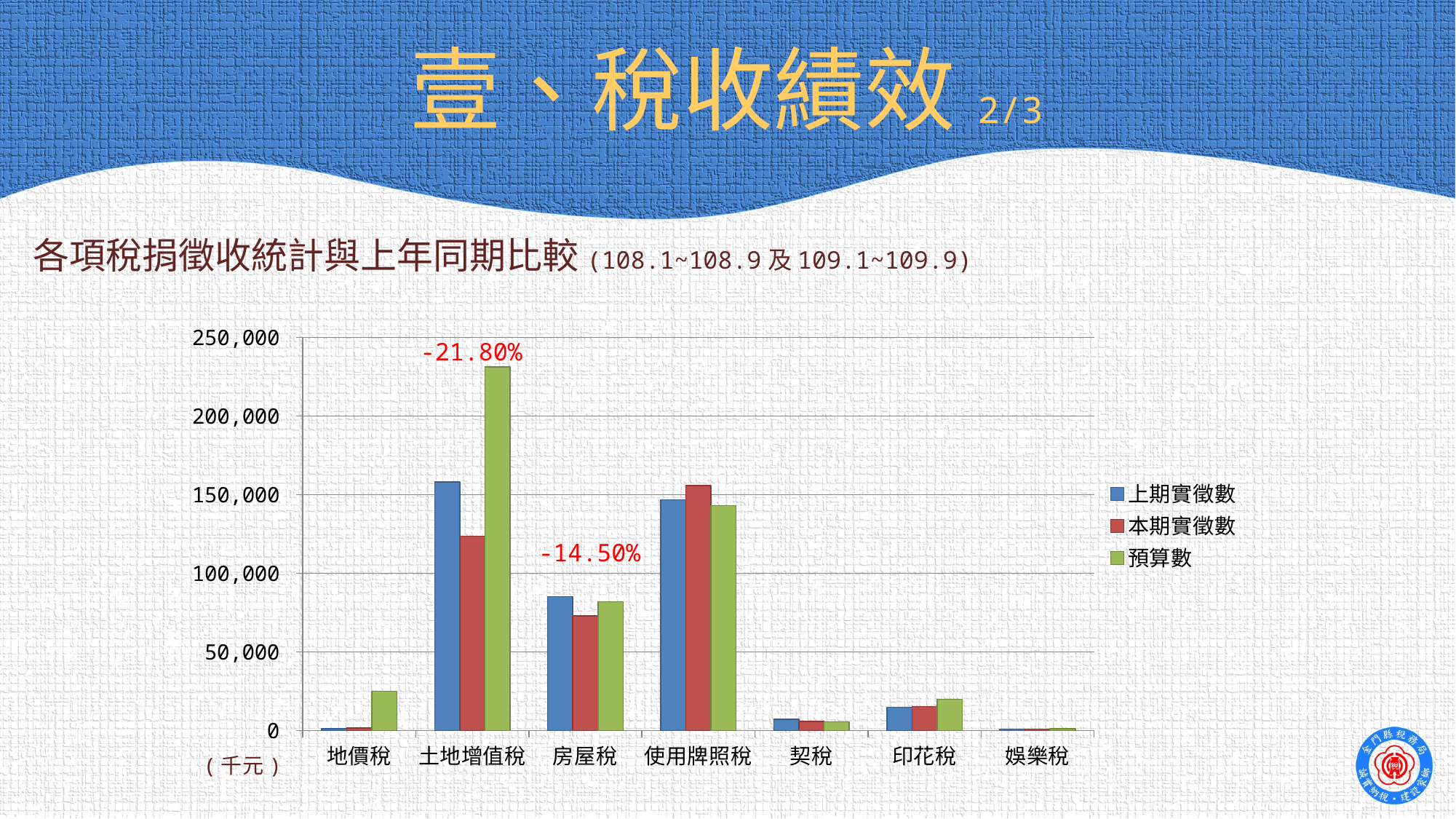
What percentage label is printed above the 房屋稅 bars? -14.50% Is the 本期實徵數 value for 土地增值稅 greater or less than 150,000? less For 土地增值稅, which is larger: 上期實徵數 or 本期實徵數? 上期實徵數 Which category has the highest 預算數 bar? 土地增值稅 Is the 上期實徵數 value for 房屋稅 greater or less than 100,000? less For 使用牌照稅, which is larger: 上期實徵數 or 本期實徵數? 本期實徵數 Which category has the lowest 預算數 bar? 娛樂稅 How many series does the chart legend list? 3 Is the 預算數 value for 土地增值稅 greater or less than 200,000? greater What percentage label is printed above the 土地增值稅 bars? -21.80% What kind of chart is shown on the slide? bar chart How many tax categories are shown on the x axis of the chart? 7